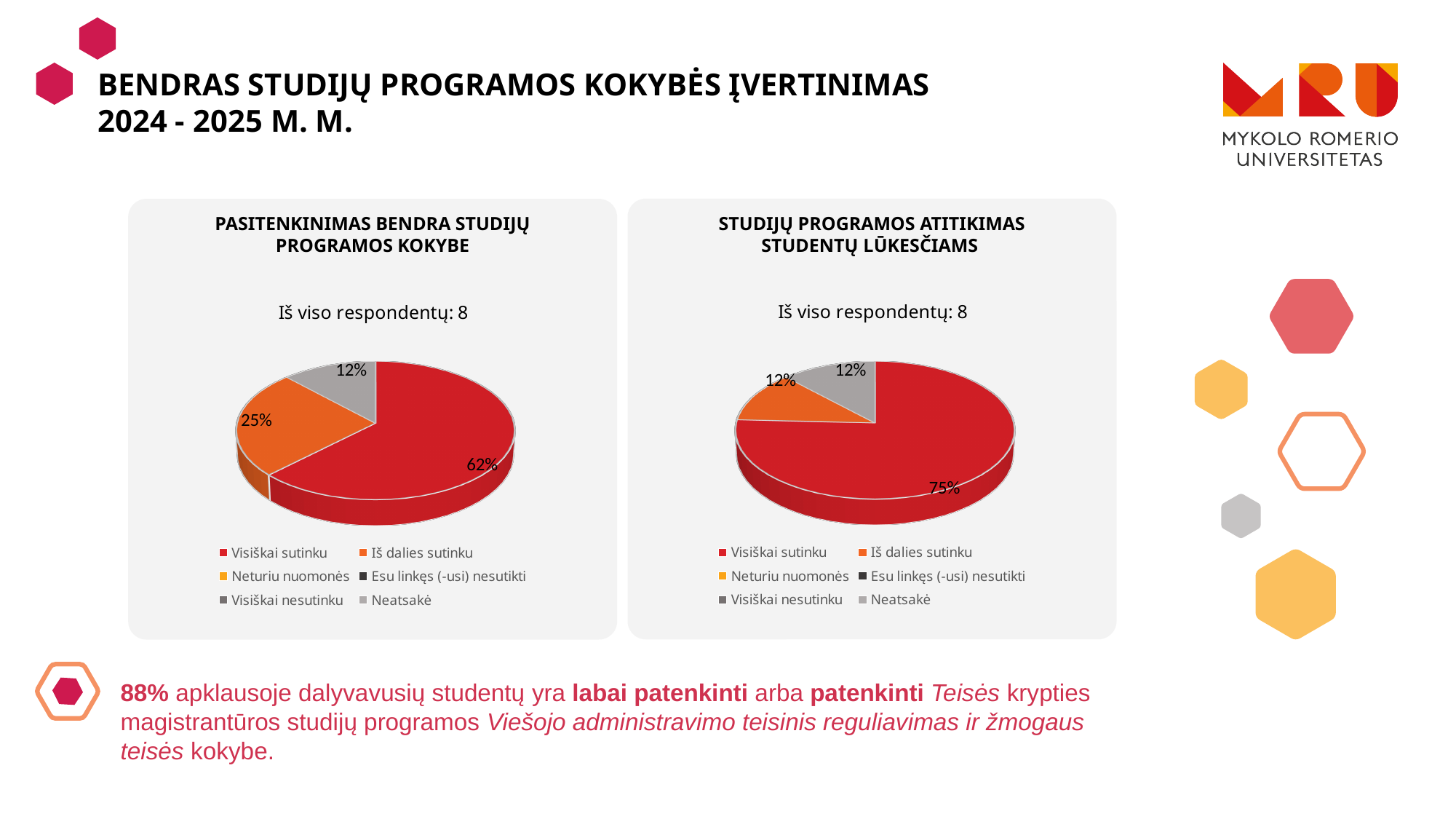
How many slices with data labels are shown in the right chart, 'Studijų programos atitikimas studentų lūkesčiams'? 3 In the right chart, 'Studijų programos atitikimas studentų lūkesčiams', what share of respondents answered 'Visiškai sutinku'? 75% Which chart has the larger 'Visiškai sutinku' share: the left chart or the right chart? The right chart In the left chart, 'Pasitenkinimas bendra studijų programos kokybe', which response has the largest slice? Visiškai sutinku In the right chart, 'Studijų programos atitikimas studentų lūkesčiams', what share of respondents answered 'Iš dalies sutinku'? 12% In the right chart, 'Studijų programos atitikimas studentų lūkesčiams', which response has the largest slice? Visiškai sutinku What kind of chart is used in the left chart, 'Pasitenkinimas bendra studijų programos kokybe'? Pie chart In the left chart, 'Pasitenkinimas bendra studijų programos kokybe', what share of respondents answered 'Iš dalies sutinku'? 25% How many entries does the legend of the left chart, 'Pasitenkinimas bendra studijų programos kokybe', list? 6 In the left chart, 'Pasitenkinimas bendra studijų programos kokybe', what is the difference between the 'Visiškai sutinku' and 'Iš dalies sutinku' shares? 37%